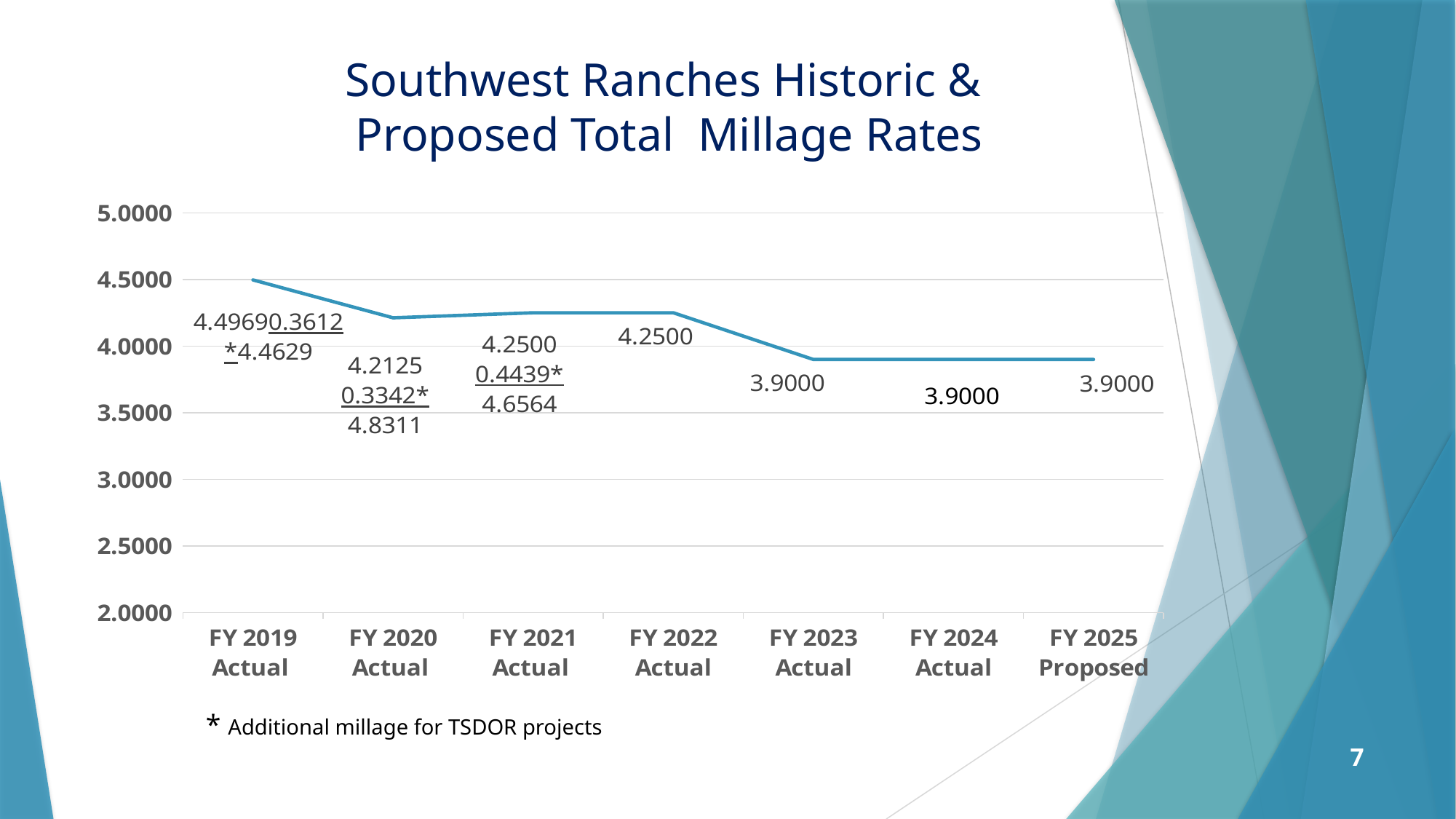
According to the footnote, what does the asterisk indicate? Additional millage for TSDOR projects What is the total millage rate for FY 2020 Actual? 4.2125 What is the difference between the FY 2022 Actual and FY 2023 Actual millage rates? 0.3500 What is the proposed total millage rate for FY 2025? 3.9000 How many fiscal years are plotted on the x axis? 7 Is the millage rate for FY 2019 Actual greater or less than 4.0000? greater What is the lowest total millage rate shown on the chart? 3.9000 What type of chart is shown on the slide? Line chart Do the total millage rates generally rise or fall from FY 2019 to FY 2025? Fall Which fiscal year has the highest total millage rate? FY 2019 Actual Which is larger, the millage rate for FY 2020 Actual or FY 2021 Actual? FY 2021 Actual What is the total millage rate for FY 2022 Actual? 4.2500